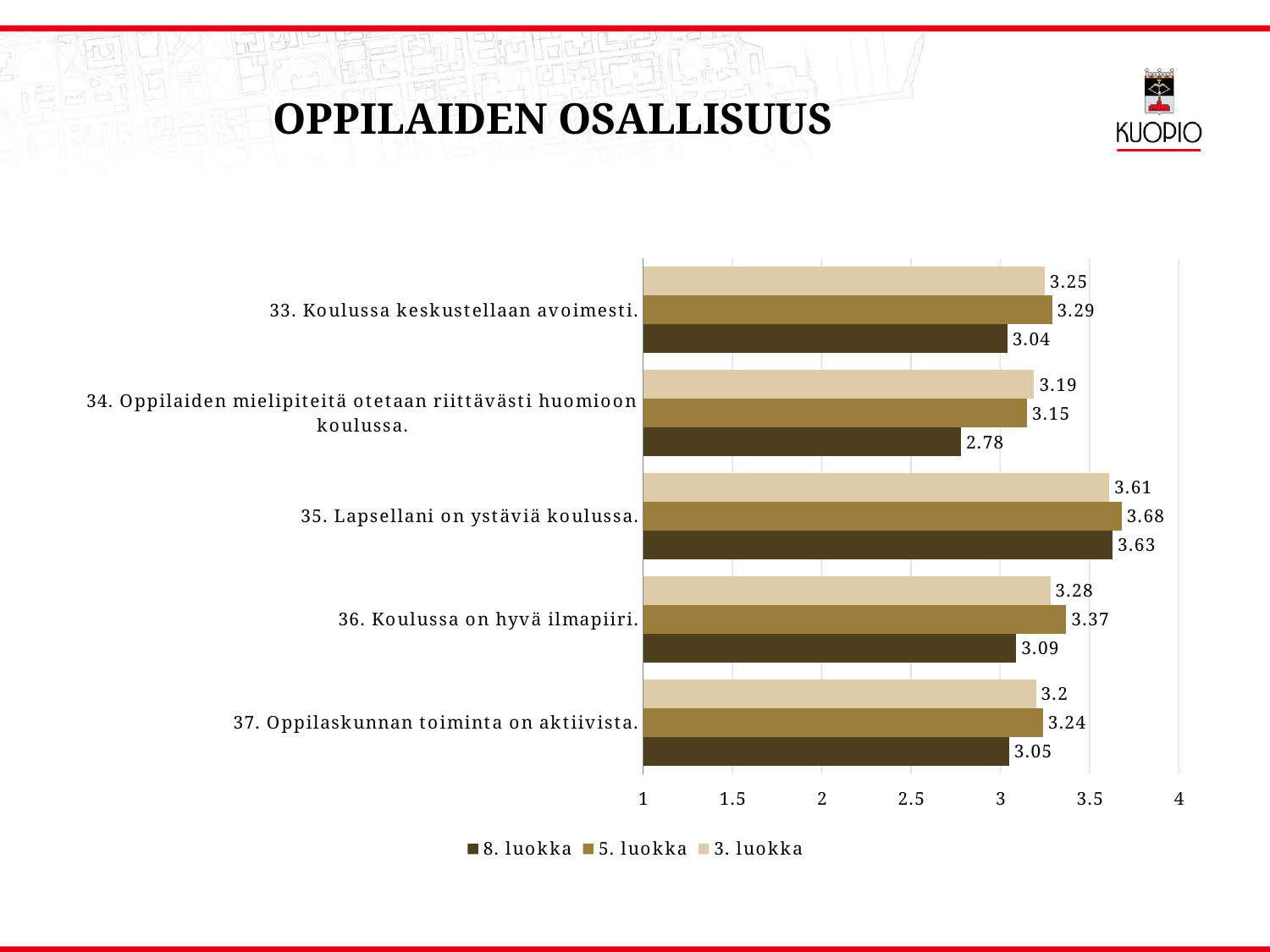
What is the title of the slide containing the chart? OPPILAIDEN OSALLISUUS For "35. Lapsellani on ystäviä koulussa.", which is larger: the 3. luokka value or the 8. luokka value? 8. luokka Which category has the lowest value for 8. luokka? 34. Oppilaiden mielipiteitä otetaan riittävästi huomioon koulussa. What kind of chart is shown on the slide? bar chart Is the 8. luokka value for "34. Oppilaiden mielipiteitä otetaan riittävästi huomioon koulussa." greater or less than 3? less What is the value for 5. luokka on "36. Koulussa on hyvä ilmapiiri."? 3.37 What is the value for 3. luokka on "37. Oppilaskunnan toiminta on aktiivista."? 3.2 Which category has the highest value for 5. luokka? 35. Lapsellani on ystäviä koulussa. How many categories (statements) are shown on the chart? 5 What is the difference between the 5. luokka and 8. luokka values for "33. Koulussa keskustellaan avoimesti."? 0.25 What is the value for 8. luokka on "34. Oppilaiden mielipiteitä otetaan riittävästi huomioon koulussa."? 2.78 How many series does the legend list? 3